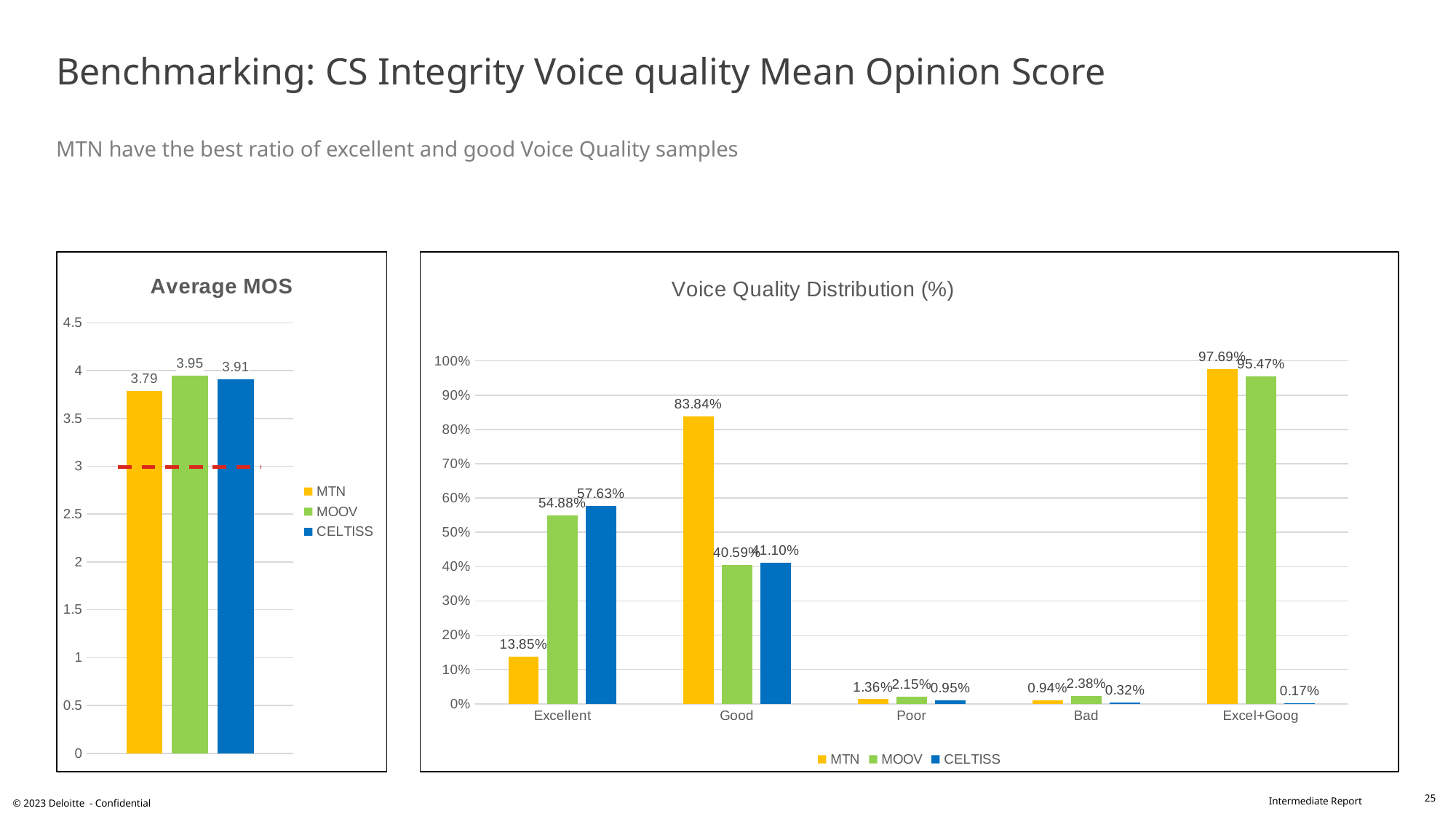
In the Voice Quality Distribution (%) chart, what is the value for CELTISS in the Excellent category? 57.63% In the Voice Quality Distribution (%) chart, what is the value for MOOV in the Poor category? 2.15% In the Voice Quality Distribution (%) chart, what is the difference between the MTN and MOOV values in the Excel+Goog category? 2.22% In the Average MOS chart, what is the value for MOOV? 3.95 In the Average MOS chart, how many series does the legend list? 3 In the Voice Quality Distribution (%) chart, what is the value for MTN in the Good category? 83.84% In the Voice Quality Distribution (%) chart, which operator has the highest value in the Excellent category? CELTISS In the Average MOS chart, which operator has the lowest average MOS? MTN In the Voice Quality Distribution (%) chart, which is larger in the Bad category: MOOV or CELTISS? MOOV What kind of chart is the Voice Quality Distribution (%) chart? Bar chart In the Voice Quality Distribution (%) chart, how many categories are shown on the x axis? 5 In the Average MOS chart, what is the difference between the MOOV and MTN values? 0.16